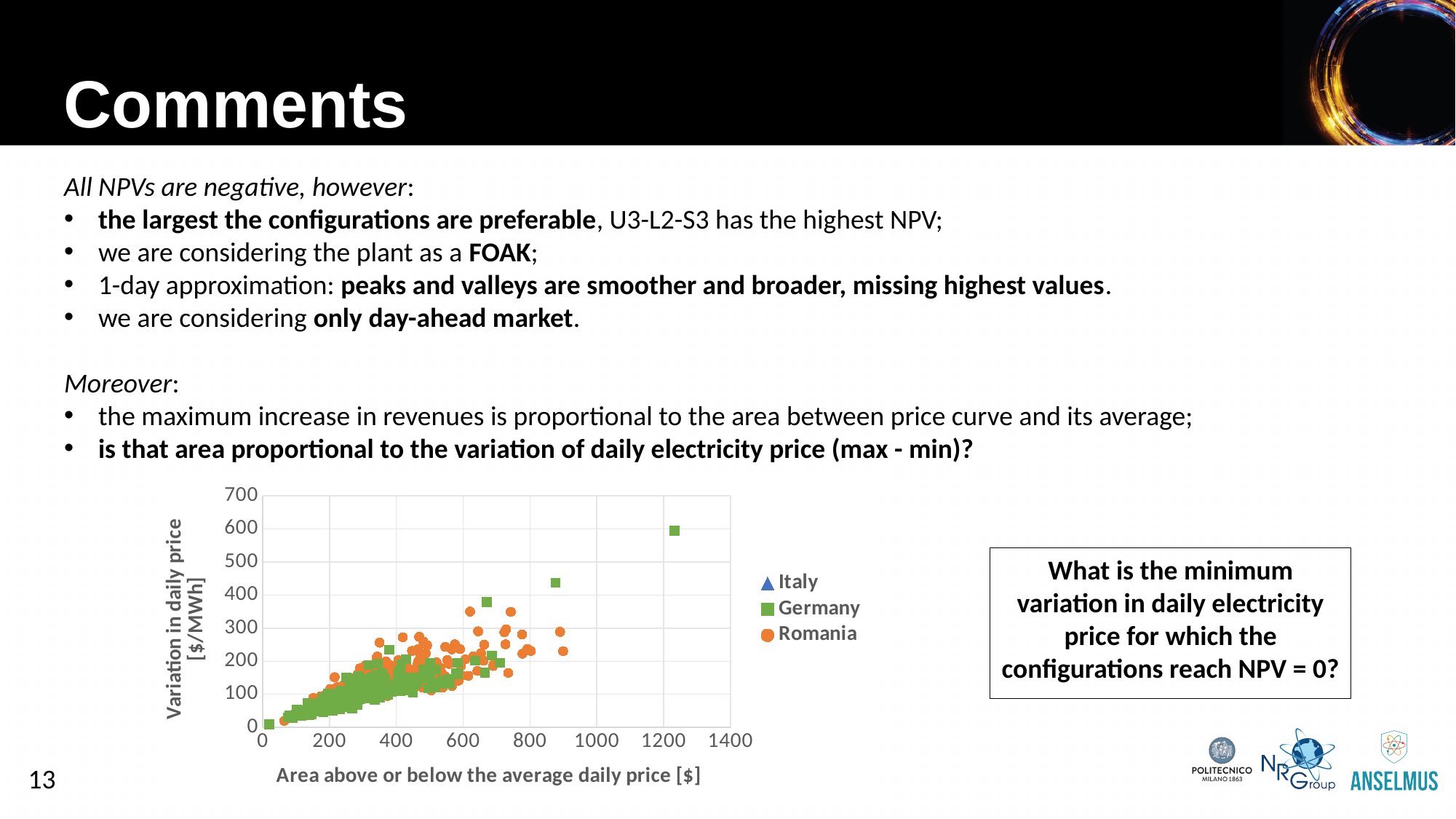
Which series contains the point with the largest area value (furthest right) in the chart? Germany What is the highest value shown on the chart's x axis? 1400 Which colour and marker represent Germany in the chart? green squares What kind of chart is shown on the slide? scatter chart Is the variation in daily price for the rightmost point in the chart greater or less than 500? greater Does the variation in daily price generally rise or fall as the area above or below the average daily price increases? rise How many series does the chart legend list? 3 What is the title of the chart's y axis? Variation in daily price [$/MWh] Is the area value of the rightmost point in the chart greater or less than 1000? greater What is the highest value shown on the chart's y axis? 700 Which countries are listed in the chart legend? Italy, Germany, Romania What is the title of the chart's x axis? Area above or below the average daily price [$]